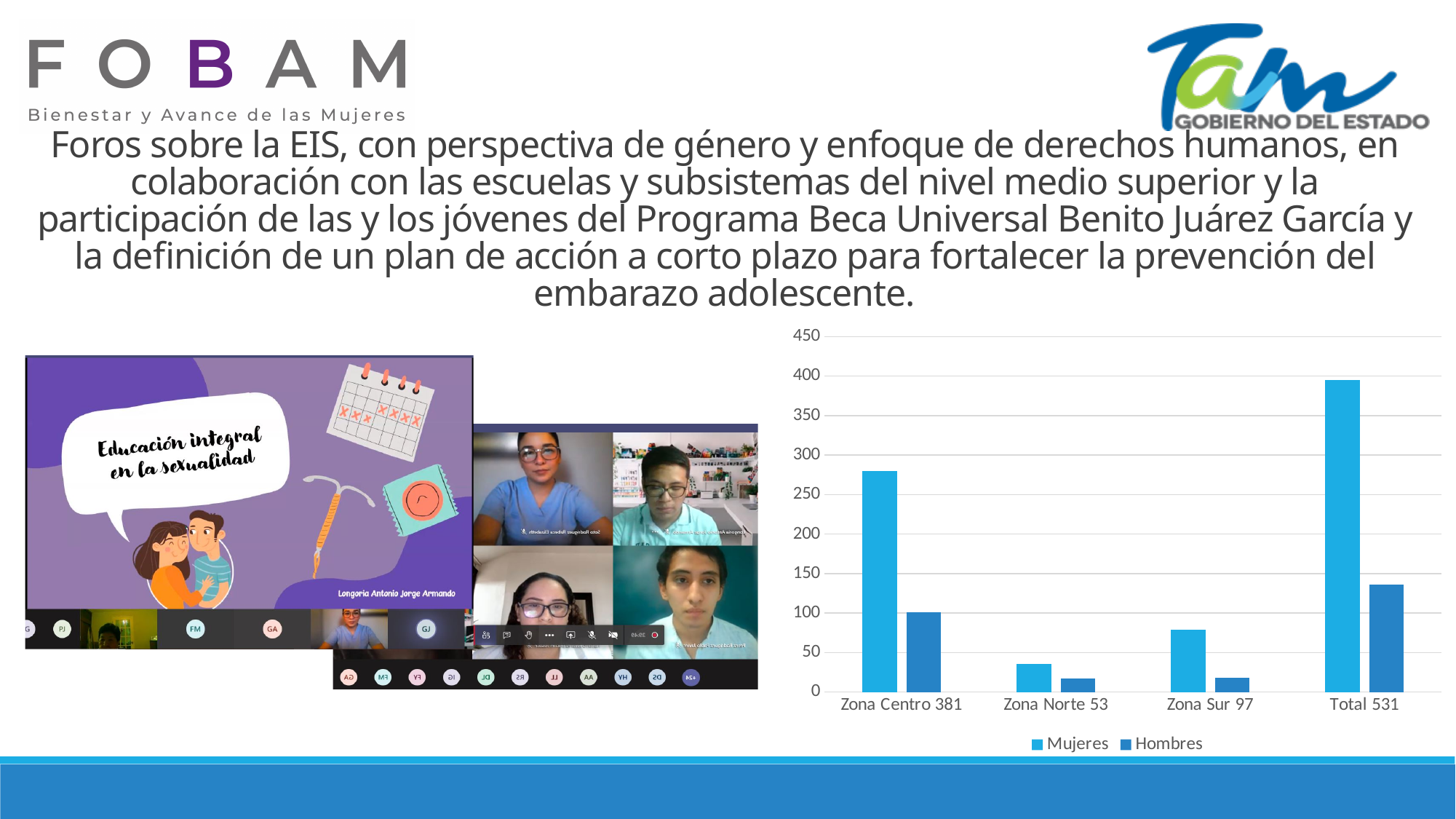
Which is larger: the Mujeres bar for Zona Sur 97 or the Mujeres bar for Zona Norte 53? Zona Sur 97 How many categories are shown on the x axis of the chart? 4 Which is larger for Zona Centro 381: the Mujeres bar or the Hombres bar? Mujeres Is the Hombres value for Zona Sur 97 greater or less than 50? less Which category has the highest Mujeres bar? Total 531 How many series does the chart legend list? 2 Is the Hombres value for Total 531 greater or less than 100? greater Is the Mujeres value for Zona Centro 381 greater or less than 250? greater What kind of chart is shown on the slide? bar chart Which category has the lowest Mujeres bar? Zona Norte 53 What are the two series names shown in the chart legend? Mujeres and Hombres